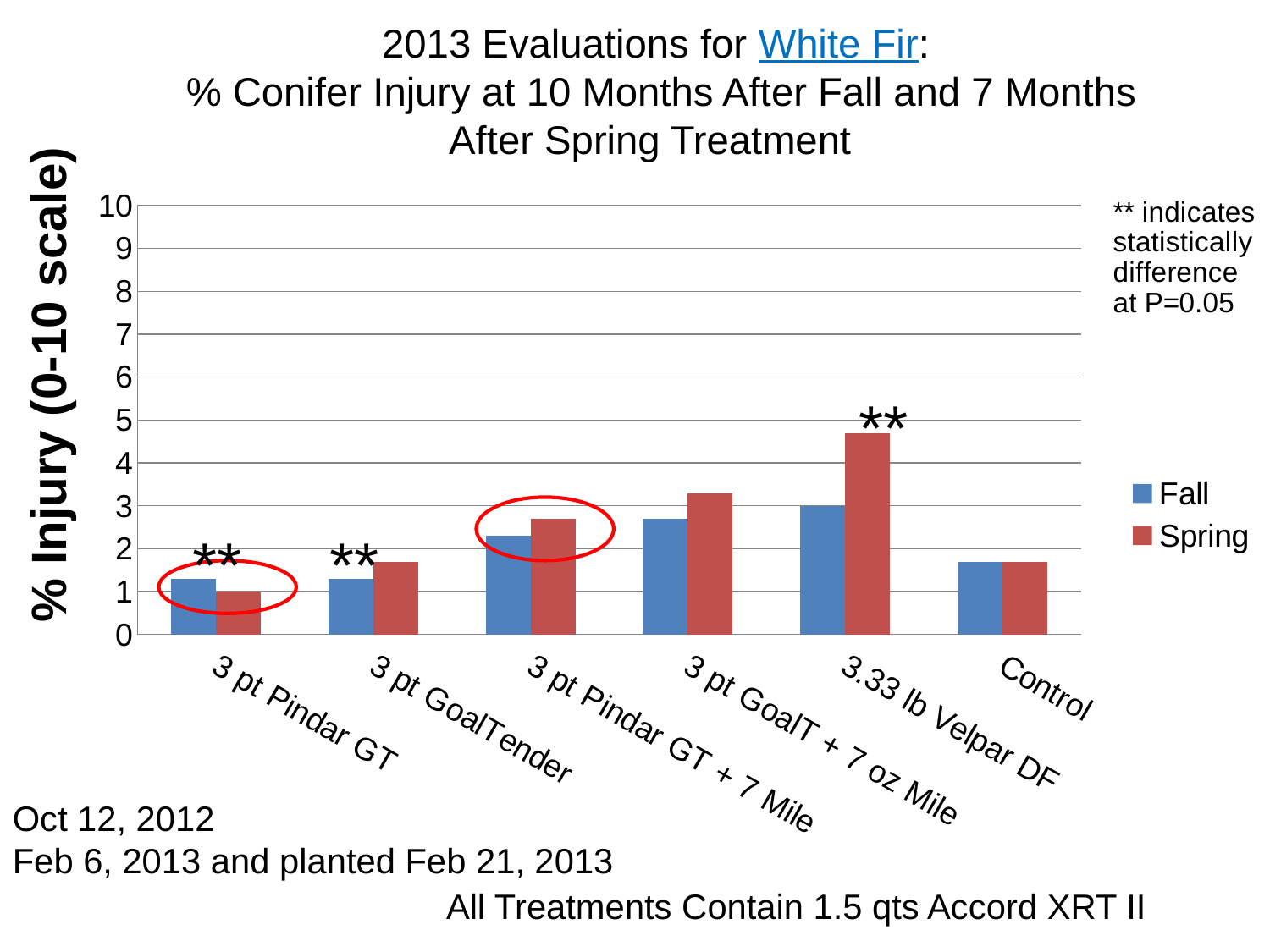
What are the two series named in the legend? Fall and Spring What is the Spring injury value for 3 pt Pindar GT? 1 Which treatment has the lowest Spring injury value? 3 pt Pindar GT Is the Spring value for 3.33 lb Velpar DF greater or less than 4? greater What kind of chart is shown on the slide? bar chart For 3 pt GoalT + 7 oz Mile, which is larger, the Fall or the Spring value? Spring What is the Fall injury value for 3.33 lb Velpar DF? 3 Which treatment has the highest Spring injury value? 3.33 lb Velpar DF How many series does the legend list? 2 Which treatment has the highest Fall injury value? 3.33 lb Velpar DF How many treatment categories are shown on the x axis? 6 Is the Fall value for 3 pt GoalTender greater or less than 2? less